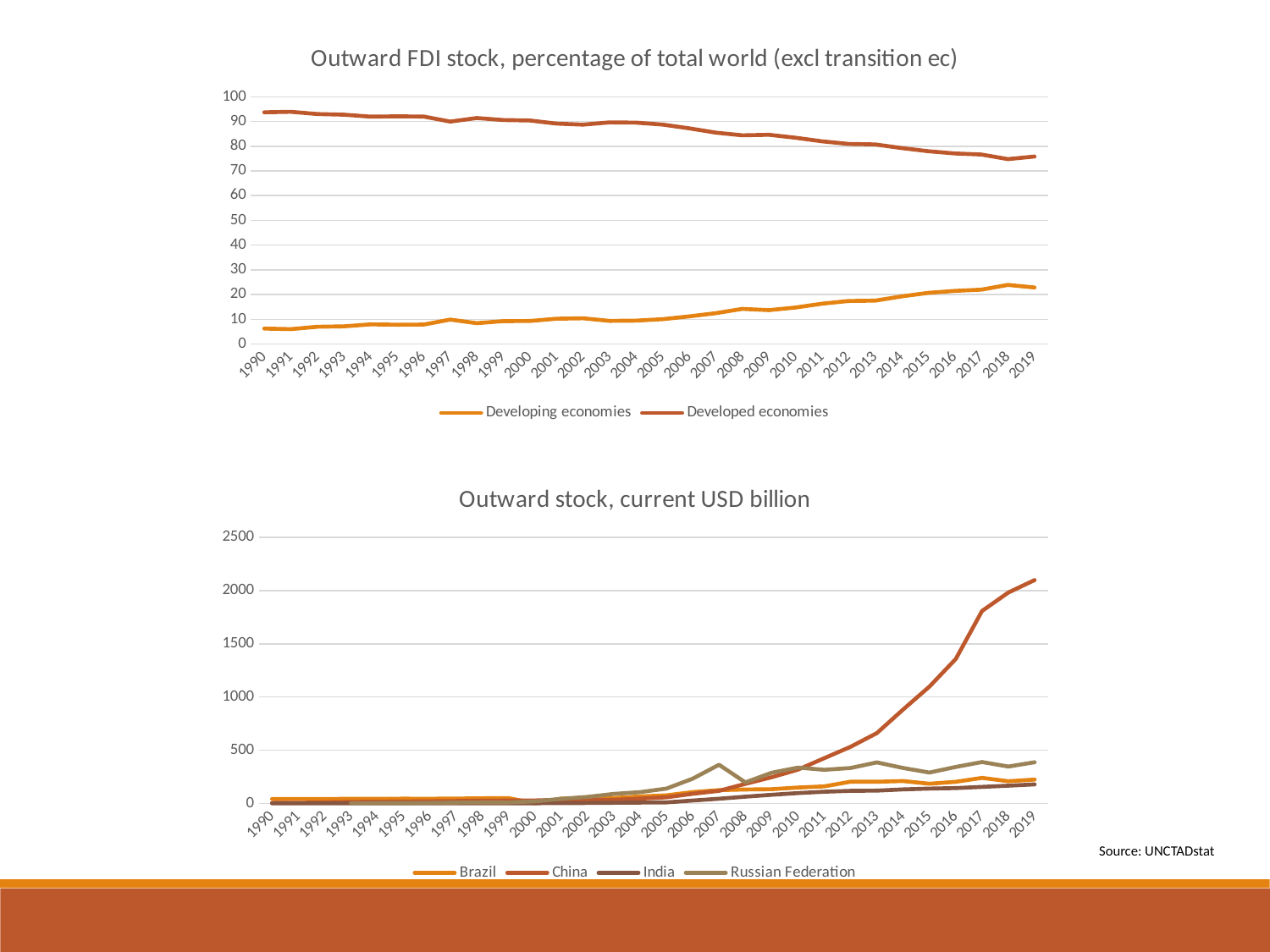
In the top chart, does the value for Developed economies rise or fall from 1990 to 2019? fall What kind of chart is the top chart titled 'Outward FDI stock, percentage of total world (excl transition ec)'? line chart In the top chart, does the value for Developing economies rise or fall from 1990 to 2019? rise What source is cited at the bottom of the slide? UNCTADstat In the top chart, how many years are shown on the x axis? 30 In the top chart, is the value for Developing economies in 2019 greater or less than 20? greater In the bottom chart 'Outward stock, current USD billion', which series has the highest value in 2019? China In the bottom chart 'Outward stock, current USD billion', which is larger in 2007, China or Russian Federation? Russian Federation How many series does the legend of the bottom chart 'Outward stock, current USD billion' list? 4 In the top chart, is the value for Developed economies in 1990 greater or less than 90? greater How many series does the legend of the top chart list? 2 In the bottom chart 'Outward stock, current USD billion', is the value for China in 2019 greater or less than 2000? greater